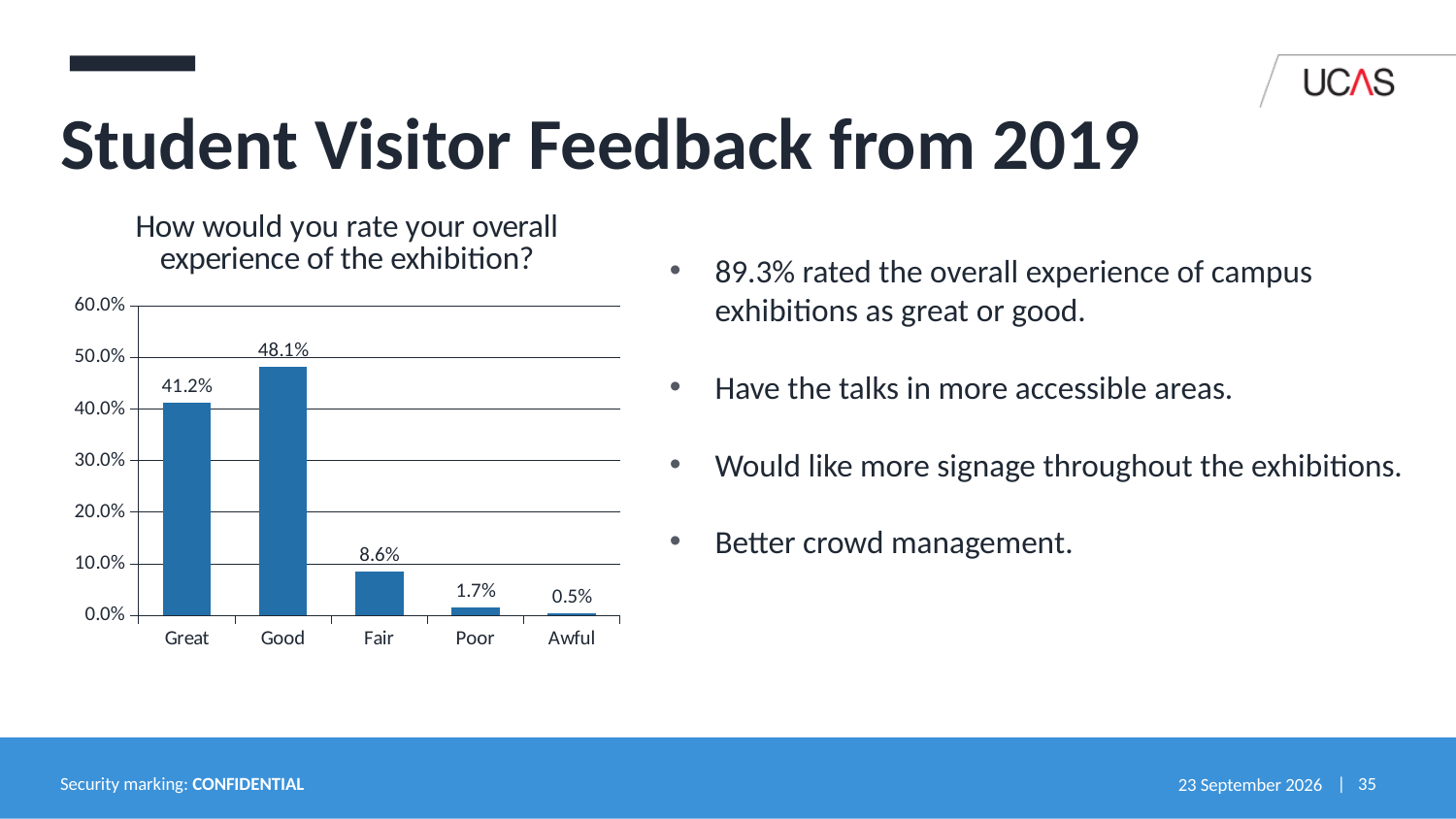
Which rating received a larger share of responses, Fair or Poor? Fair Do the values generally rise or fall moving from Good to Awful along the x axis? Fall How many rating categories are shown on the x axis of the chart? 5 What percentage of student visitors rated their overall experience as Poor? 1.7% What is the title of the chart on the slide? How would you rate your overall experience of the exhibition? What percentage of student visitors rated their overall experience as Fair? 8.6% What percentage of student visitors rated their overall experience of the exhibition as Great? 41.2% Is the value for Great greater or less than 40.0%? greater What type of chart is used to show the overall experience ratings? Bar chart What is the difference in percentage points between the Good and Great ratings? 6.9 Which rating category has the highest percentage in the chart? Good Which rating category has the lowest percentage in the chart? Awful